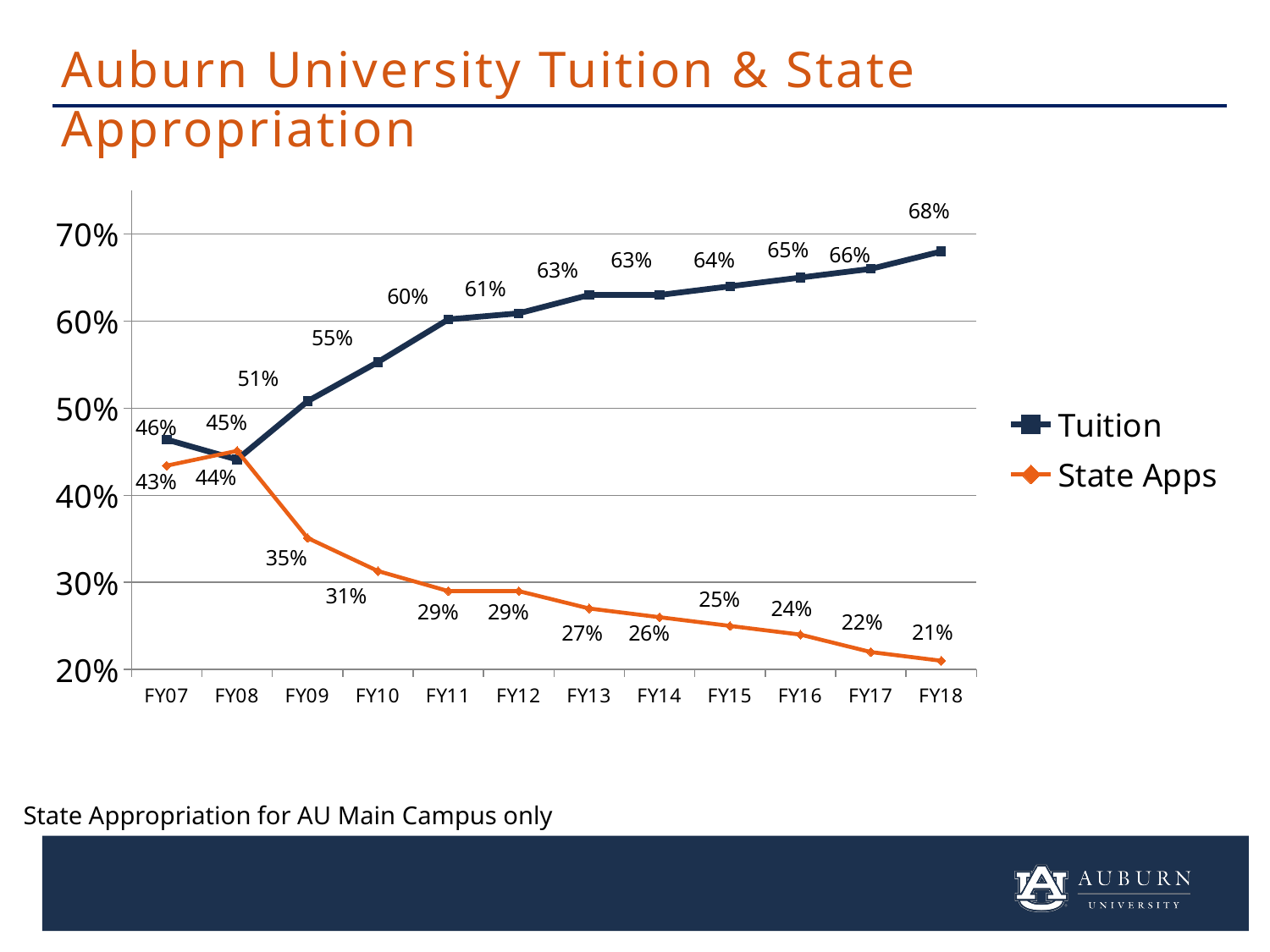
In which fiscal year is the State Apps value lowest? FY18 Does the State Apps series generally rise or fall from FY09 to FY18? Fall How many fiscal years are plotted on the x axis? 12 In FY07, which is larger, Tuition or State Apps? Tuition What kind of chart is shown on the slide? Line chart What is the State Apps value for FY18? 21% What is the Tuition value for FY11? 60% How many series does the legend list? 2 What is the difference between the Tuition and State Apps values in FY18? 47 percentage points In which fiscal year is the Tuition value highest? FY18 What is the Tuition value for FY18? 68% What is the State Apps value for FY09? 35%